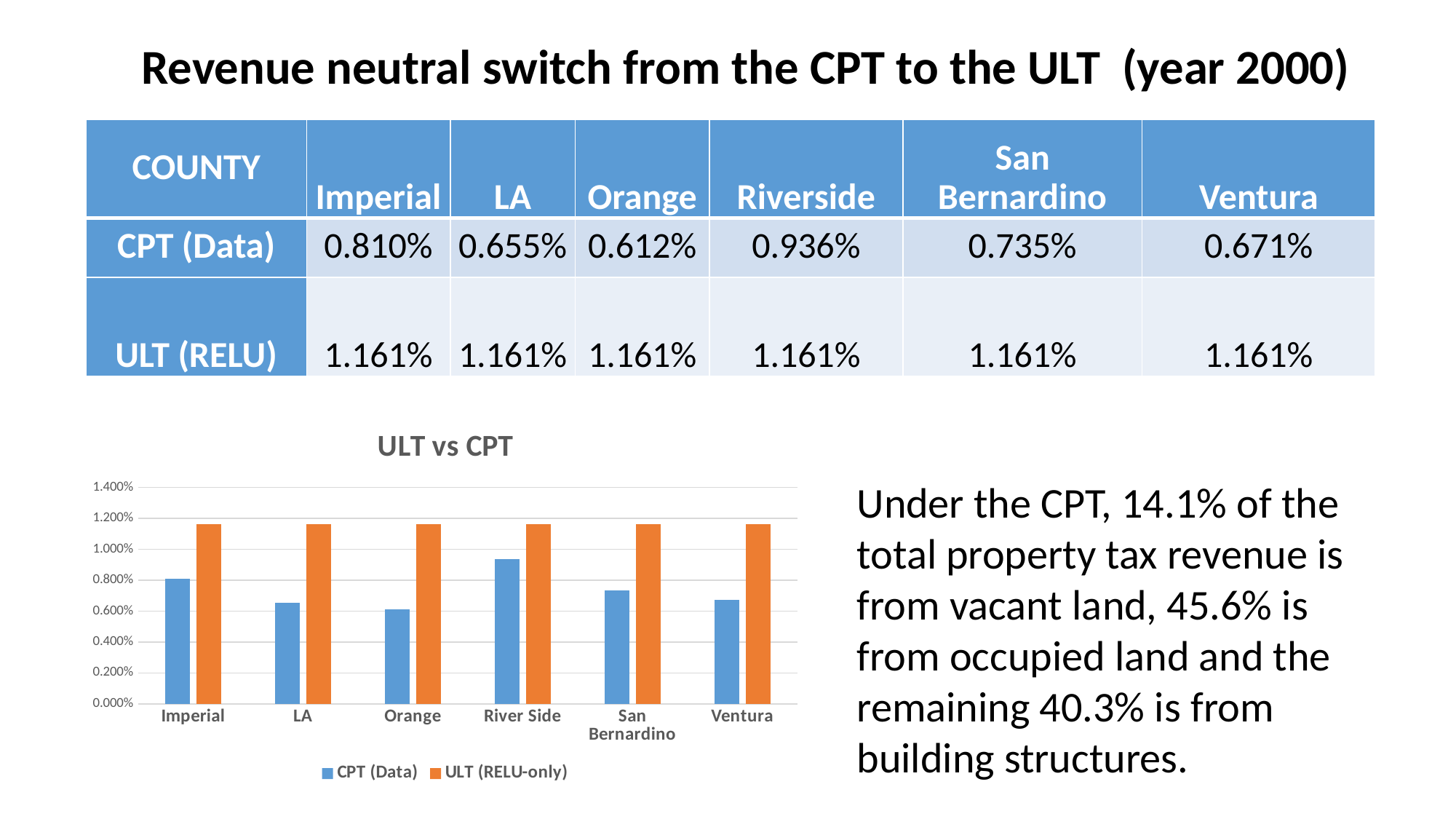
What kind of chart is the "ULT vs CPT" chart? bar chart How many series does the legend of the "ULT vs CPT" chart list? 2 In the "ULT vs CPT" chart, is the ULT (RELU-only) bar for LA greater or less than 1.000%? greater Which county has the highest CPT (Data) value? Riverside What is the ULT (RELU) value for Orange? 1.161% What is the CPT (Data) value for Riverside? 0.936% What is the difference between the ULT (RELU) value and the CPT (Data) value for Imperial? 0.351% Which county has the lowest CPT (Data) value? Orange In the "ULT vs CPT" chart, is the CPT (Data) bar for San Bernardino greater or less than 0.800%? less Which is larger, the CPT (Data) value for LA or for Ventura? Ventura How many counties are shown on the x axis of the "ULT vs CPT" chart? 6 In the "ULT vs CPT" chart, which colour represents the ULT (RELU-only) series? orange